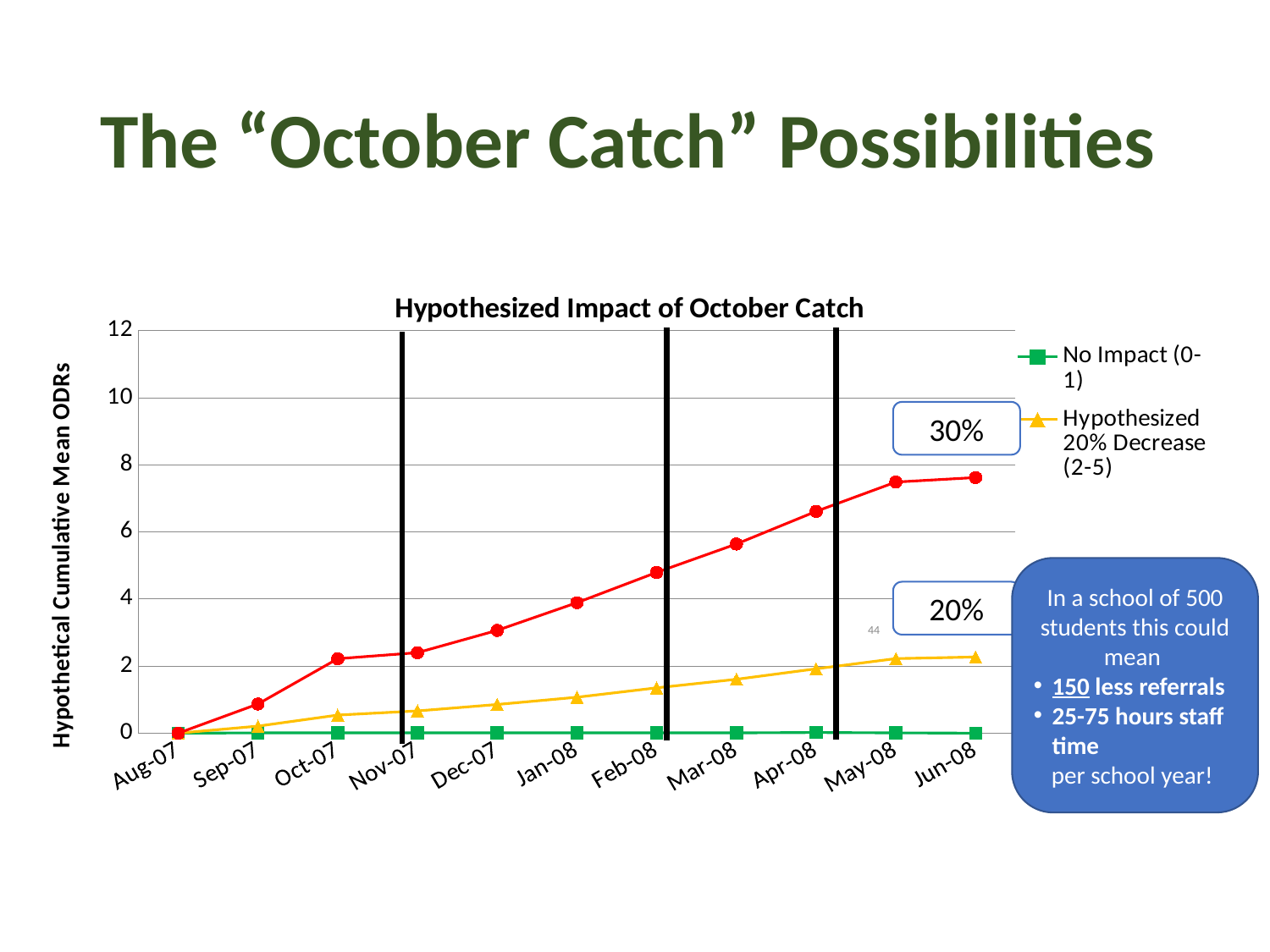
How many months are plotted along the x axis of the chart? 11 Is the value of the red line at Jun-08 greater or less than 6? greater What is the title of the chart? Hypothesized Impact of October Catch Does the red line rise or fall from Aug-07 to Jun-08? Rise What kind of chart is shown on the slide? Line chart How many lines are plotted on the chart? 3 Is the value of the red line at Mar-08 greater or less than 4? greater What is the label on the vertical axis of the chart? Hypothetical Cumulative Mean ODRs In which month does the red line reach its highest value? Jun-08 Is the value of the red line at Jun-08 greater or less than 8? less At Jun-08, which line has the larger value, the red line or the Hypothesized 20% Decrease line? The red line